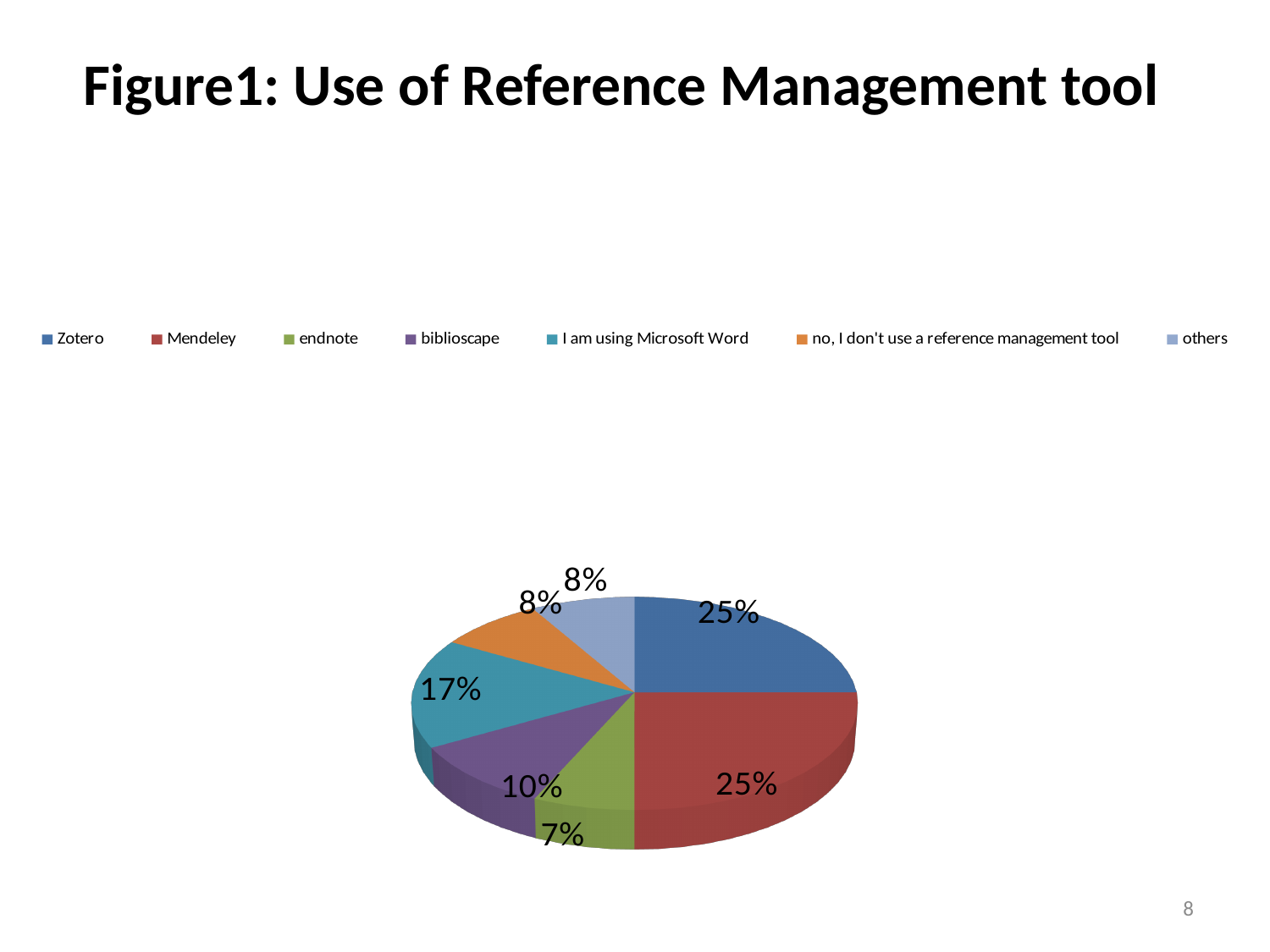
What is the difference between the share for 'I am using Microsoft Word' and the share for biblioscape? 7% What is the title of the chart on the slide? Figure1: Use of Reference Management tool Which is larger, the share for biblioscape or the share for endnote? biblioscape What share of the pie does Zotero have? 25% What share of the pie does 'no, I don't use a reference management tool' have? 8% How many categories does the legend list? 7 What share of the pie does Mendeley have? 25% Which category has the smallest slice of the pie? endnote What kind of chart is shown on the slide? pie chart